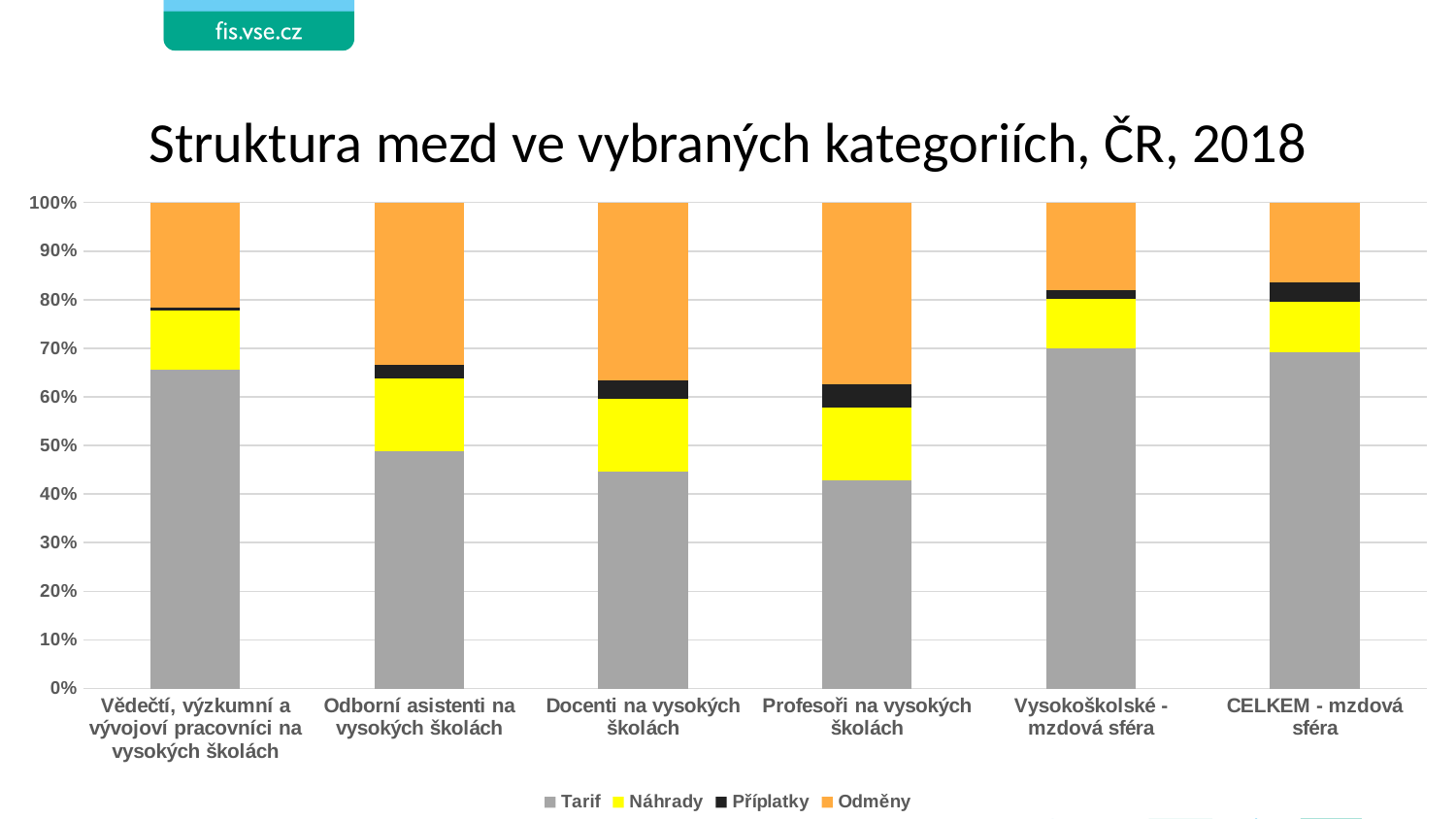
Is the Tarif share for Profesoři na vysokých školách greater or less than 50%? less Is the Tarif share for Vědečtí, výzkumní a vývojoví pracovníci na vysokých školách greater or less than 60%? greater Is the Tarif share for Docenti na vysokých školách greater or less than 50%? less What kind of chart is shown on the slide? Stacked bar chart Which has a larger Příplatky share: CELKEM - mzdová sféra or Vědečtí, výzkumní a vývojoví pracovníci na vysokých školách? CELKEM - mzdová sféra What is the title of the chart? Struktura mezd ve vybraných kategoriích, ČR, 2018 Which has a larger Odměny share: Profesoři na vysokých školách or Vysokoškolské - mzdová sféra? Profesoři na vysokých školách How many series does the legend list? 4 Which series is shown in grey in the chart? Tarif How many categories are shown on the x axis of the chart? 6 Which has a larger Tarif share: Vědečtí, výzkumní a vývojoví pracovníci na vysokých školách or Profesoři na vysokých školách? Vědečtí, výzkumní a vývojoví pracovníci na vysokých školách